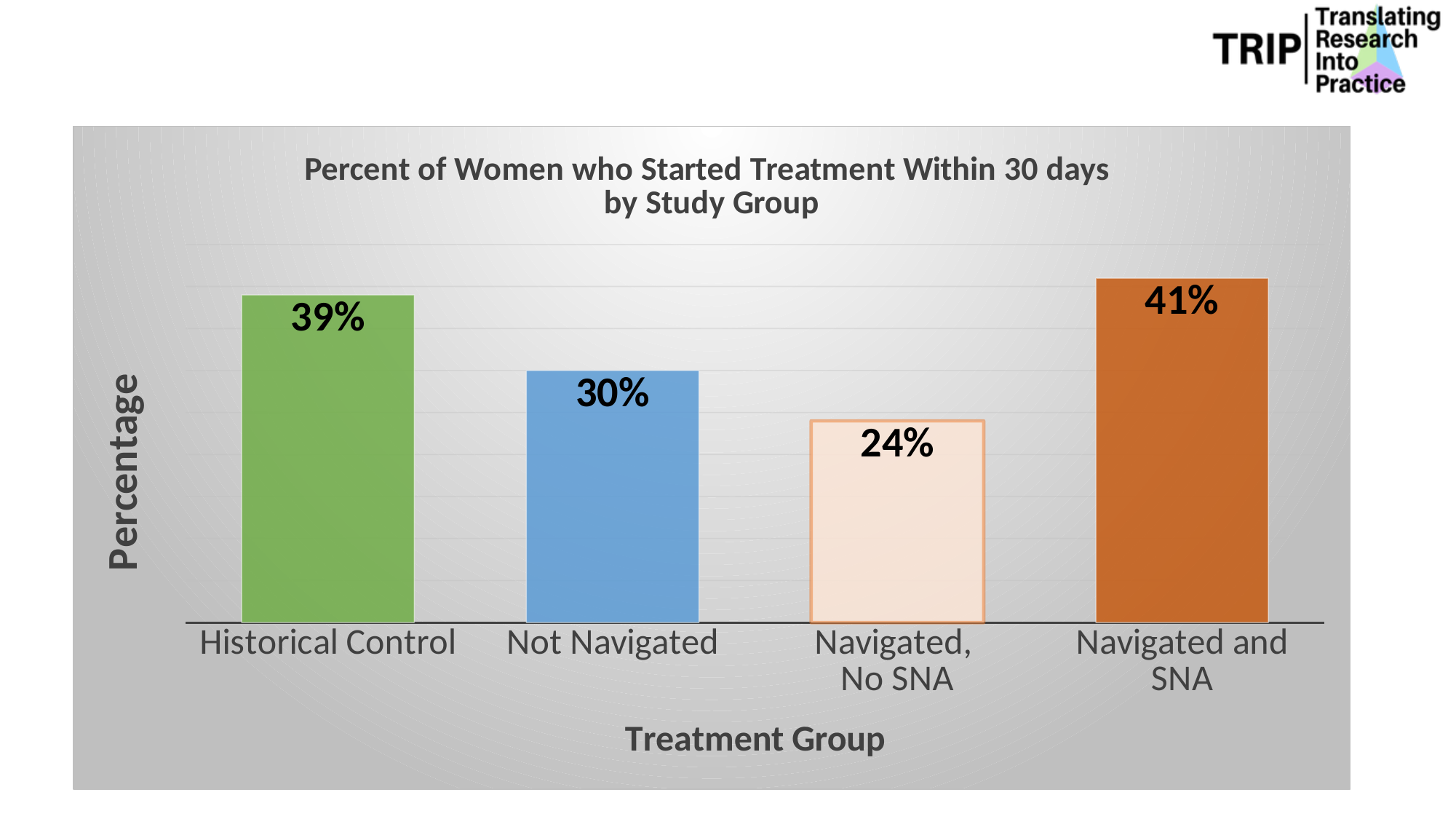
Which is larger, the value for Historical Control or the value for Not Navigated? Historical Control Which study group has the lowest percentage? Navigated, No SNA What is the difference between the values for Navigated and SNA and Navigated, No SNA? 17% What is the value for Navigated, No SNA? 24% Which study group has the highest percentage? Navigated and SNA What is the value for Not Navigated? 30% How many study groups are shown in the chart? 4 What is the difference between the values for Historical Control and Not Navigated? 9% What is the title of the chart? Percent of Women who Started Treatment Within 30 days by Study Group What is the value for Historical Control? 39% What kind of chart is shown on the slide? Bar chart What is the value for Navigated and SNA? 41%